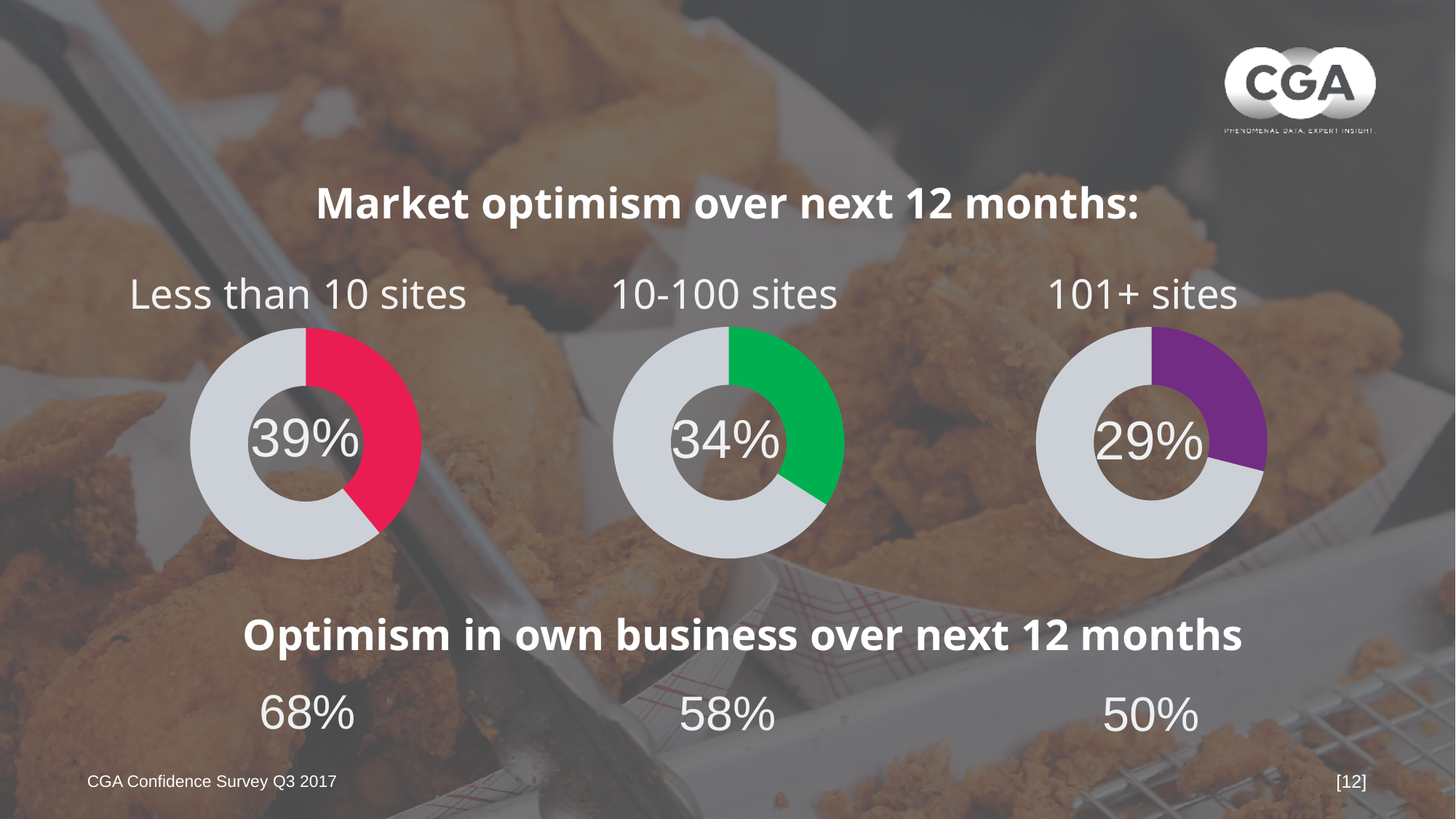
What is the market optimism value shown in the 'Less than 10 sites' donut chart? 39% What is the difference in market optimism between 'Less than 10 sites' and '101+ sites'? 10 percentage points What colour is the filled segment of the '10-100 sites' donut chart? Green What kind of chart is used to show market optimism for each site-size group? Donut chart Do the market optimism values rise or fall as the site-size group increases from left to right? Fall What is the market optimism value shown in the '10-100 sites' donut chart? 34% How many donut charts are shown on the slide? 3 Is market optimism higher for '10-100 sites' or '101+ sites'? 10-100 sites Which site-size group has the lowest market optimism over the next 12 months? 101+ sites What is the difference in market optimism between 'Less than 10 sites' and '10-100 sites'? 5 percentage points What is the market optimism value shown in the '101+ sites' donut chart? 29% Which site-size group has the highest market optimism over the next 12 months? Less than 10 sites